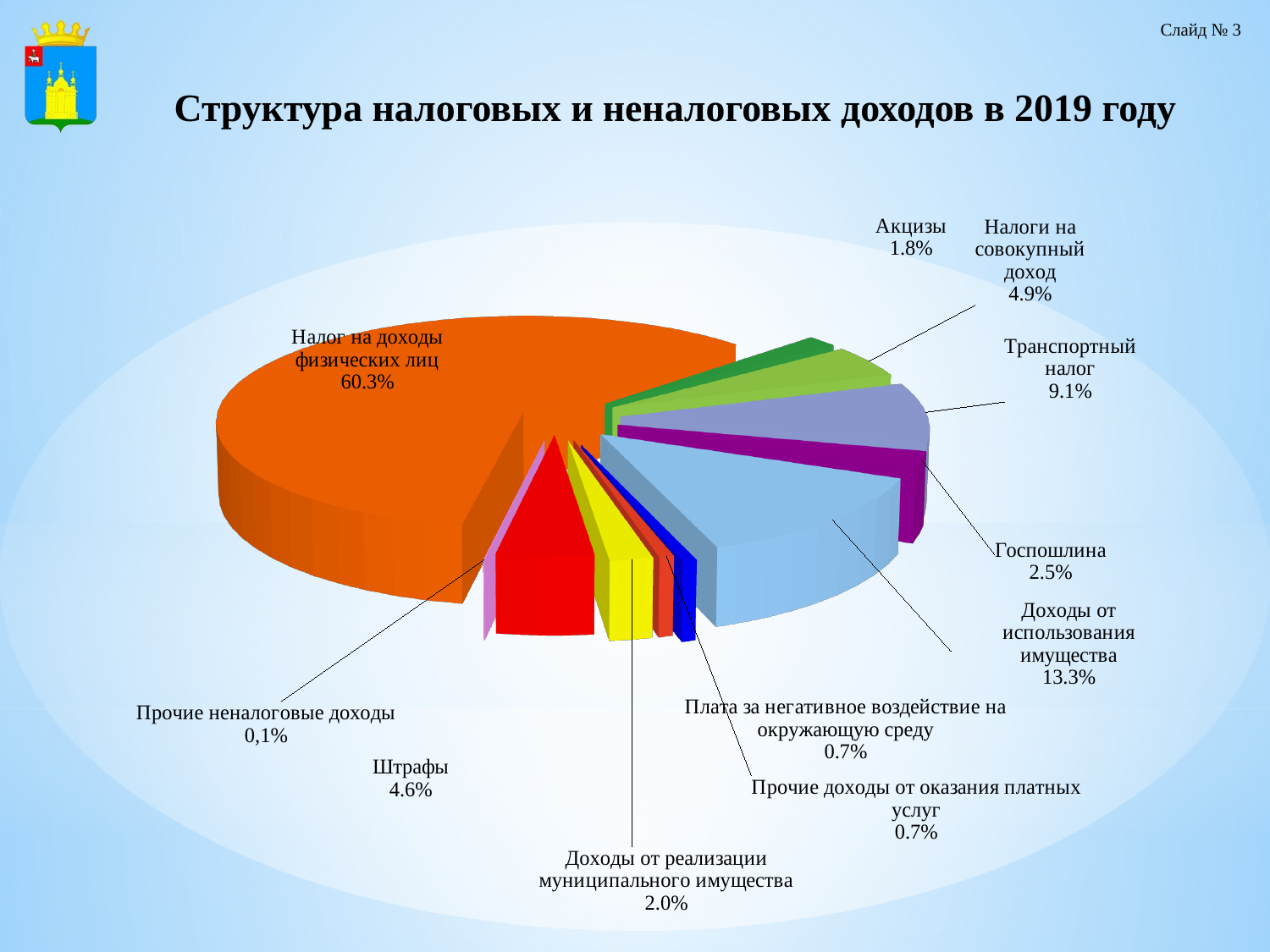
What is the value shown for Штрафы? 4.6% Which is larger: Госпошлина or Акцизы? Госпошлина Which category has the smallest slice of the pie? Прочие неналоговые доходы What is the title of the chart? Структура налоговых и неналоговых доходов в 2019 году What kind of chart is shown on the slide? Pie chart Which category has the largest slice of the pie? Налог на доходы физических лиц What is the difference between the values for Транспортный налог and Налоги на совокупный доход? 4.2% What share of the pie does Налог на доходы физических лиц represent? 60.3% How many slices does the pie chart have? 11 What is the value shown for Доходы от использования имущества? 13.3% What is the value shown for Прочие неналоговые доходы? 0,1% What is the value shown for Транспортный налог? 9.1%